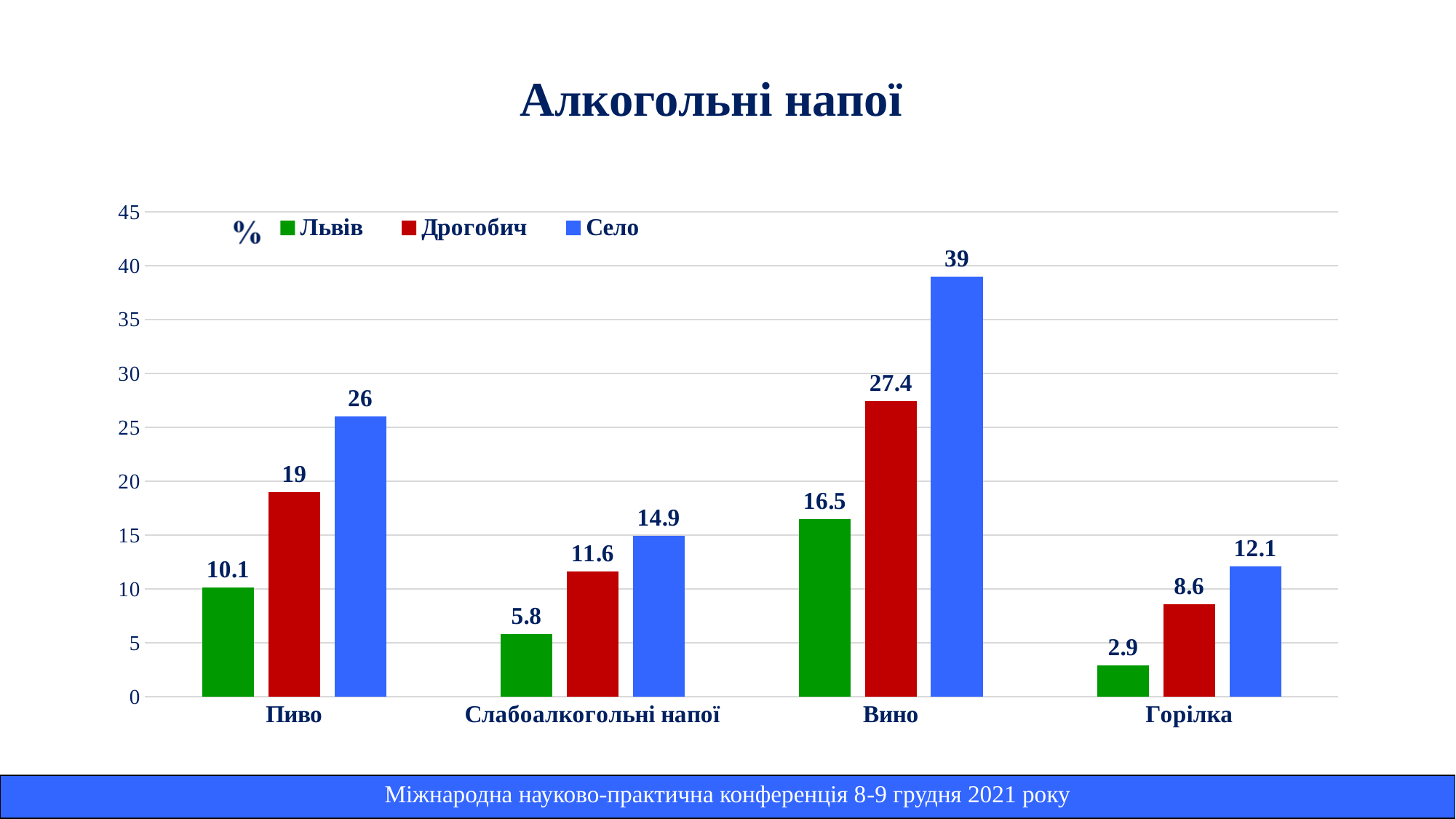
Which category has the highest value for the Львів series? Вино What is the value for Львів in the Пиво category? 10.1 What is the title of the chart? Алкогольні напої Which is larger: the Дрогобич value for Слабоалкогольні напої or the Львів value for Вино? Львів value for Вино How many series does the legend list? 3 Which category has the lowest value for the Село series? Горілка How many categories are shown on the x axis? 4 What is the value for Село in the Вино category? 39 What kind of chart is shown on the slide? bar chart Is the value for Село in the Слабоалкогольні напої category greater or less than 15? less What is the value for Дрогобич in the Горілка category? 8.6 What is the difference between the Село and Дрогобич values in the Пиво category? 7